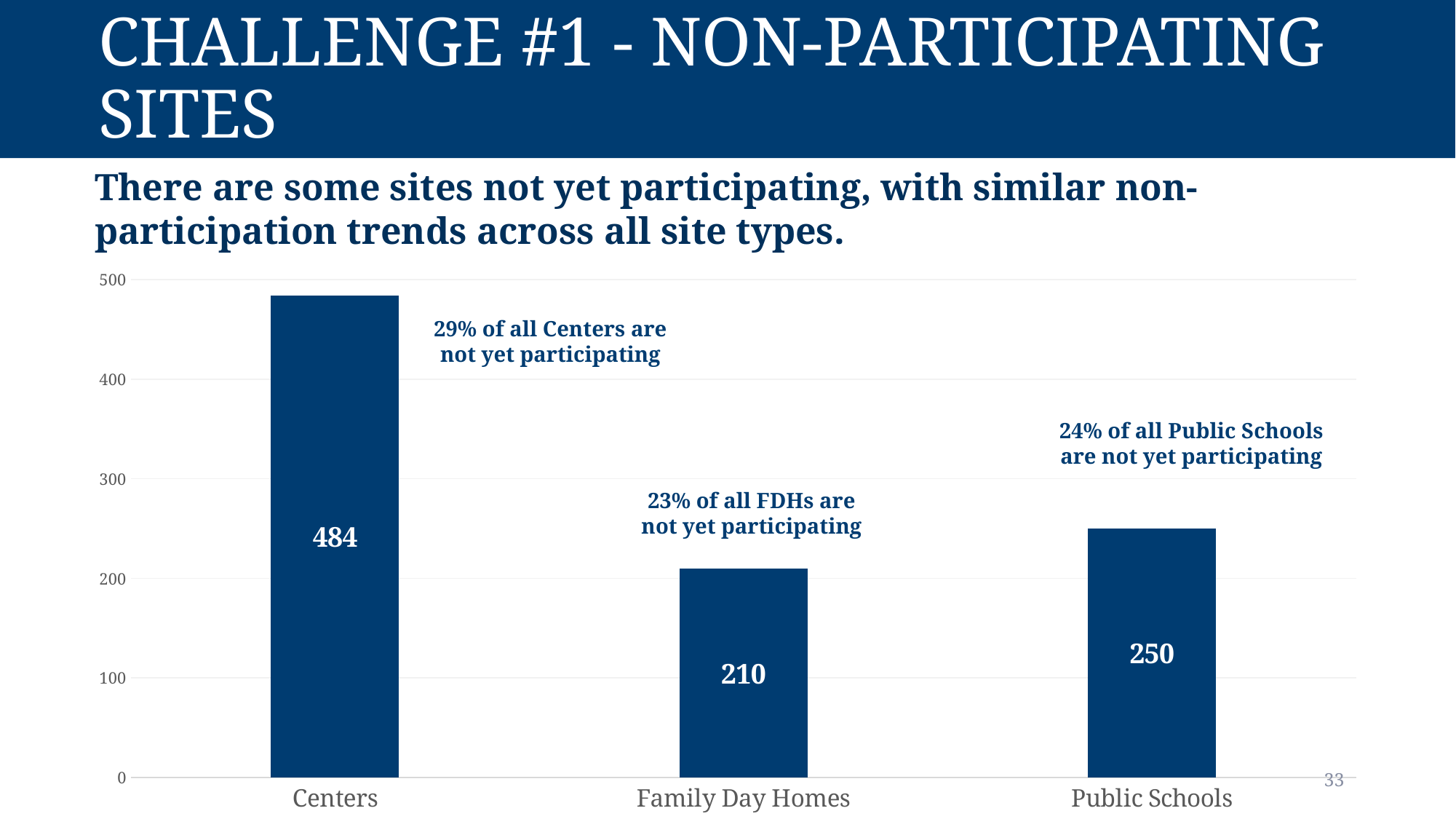
Which category has the highest value? Centers What is the value for Public Schools? 250 What is the value for Family Day Homes? 210 What is the difference between the values for Centers and Public Schools? 234 What is the difference between the values for Public Schools and Family Day Homes? 40 According to the annotation on the chart, what percentage of all Centers are not yet participating? 29% Which is larger, the value for Family Day Homes or the value for Public Schools? Public Schools What kind of chart is shown on the slide? bar chart What is the value for Centers? 484 Is the value for Centers greater or less than 400? greater Which category has the lowest value? Family Day Homes How many categories are shown on the x axis? 3